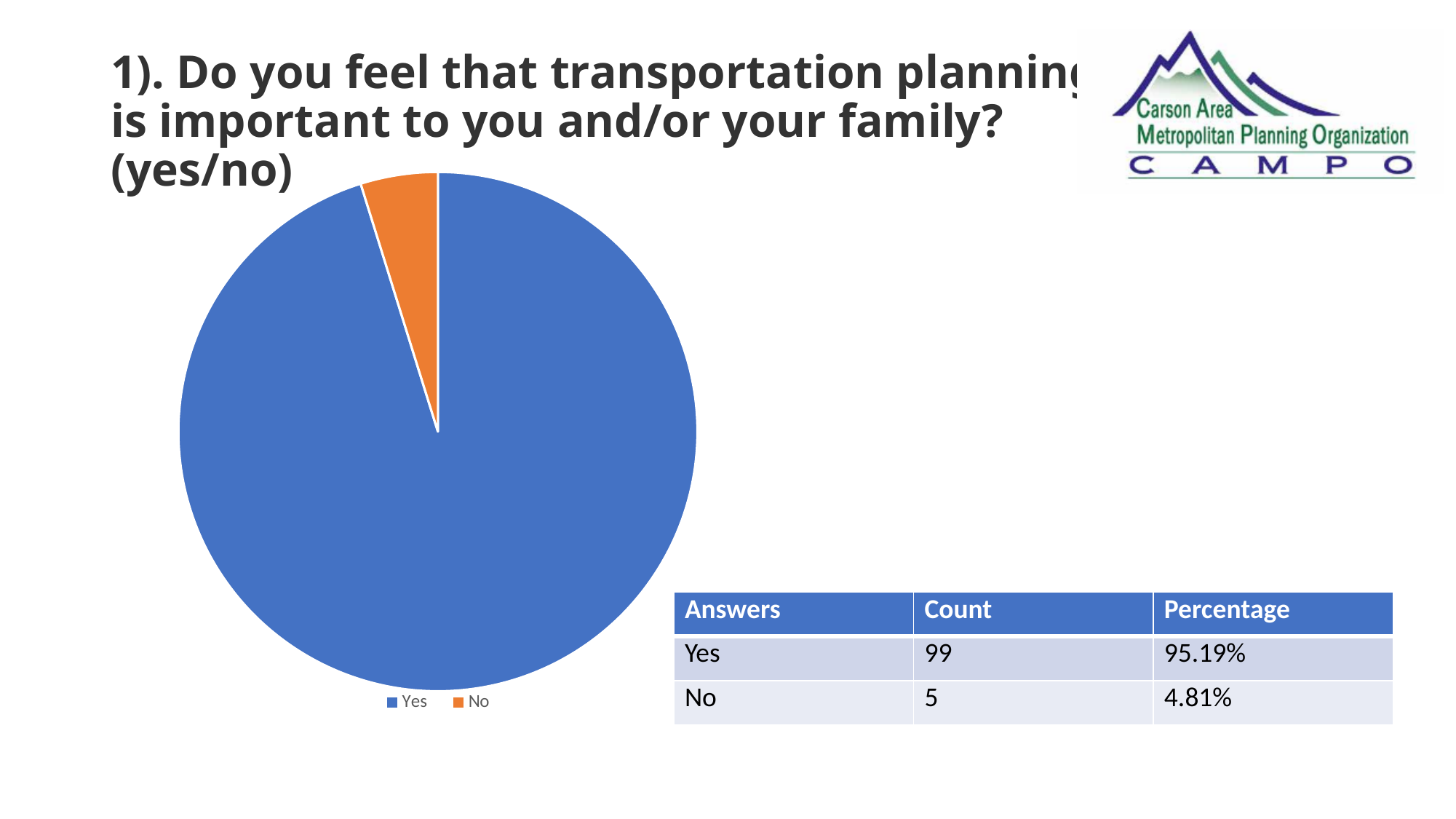
What percentage of responses were Yes? 95.19% How many slices does the pie chart have? 2 What colour is the Yes slice in the pie chart? blue What kind of chart is shown on the slide? pie chart Which is larger, the Yes slice or the No slice? Yes Which answer has the largest slice in the pie chart? Yes What is the difference between the Yes count and the No count? 94 What is the count for the No answer? 5 Which answer has the smallest slice in the pie chart? No What percentage of responses were No? 4.81% How many entries does the pie chart's legend list? 2 What is the count for the Yes answer? 99